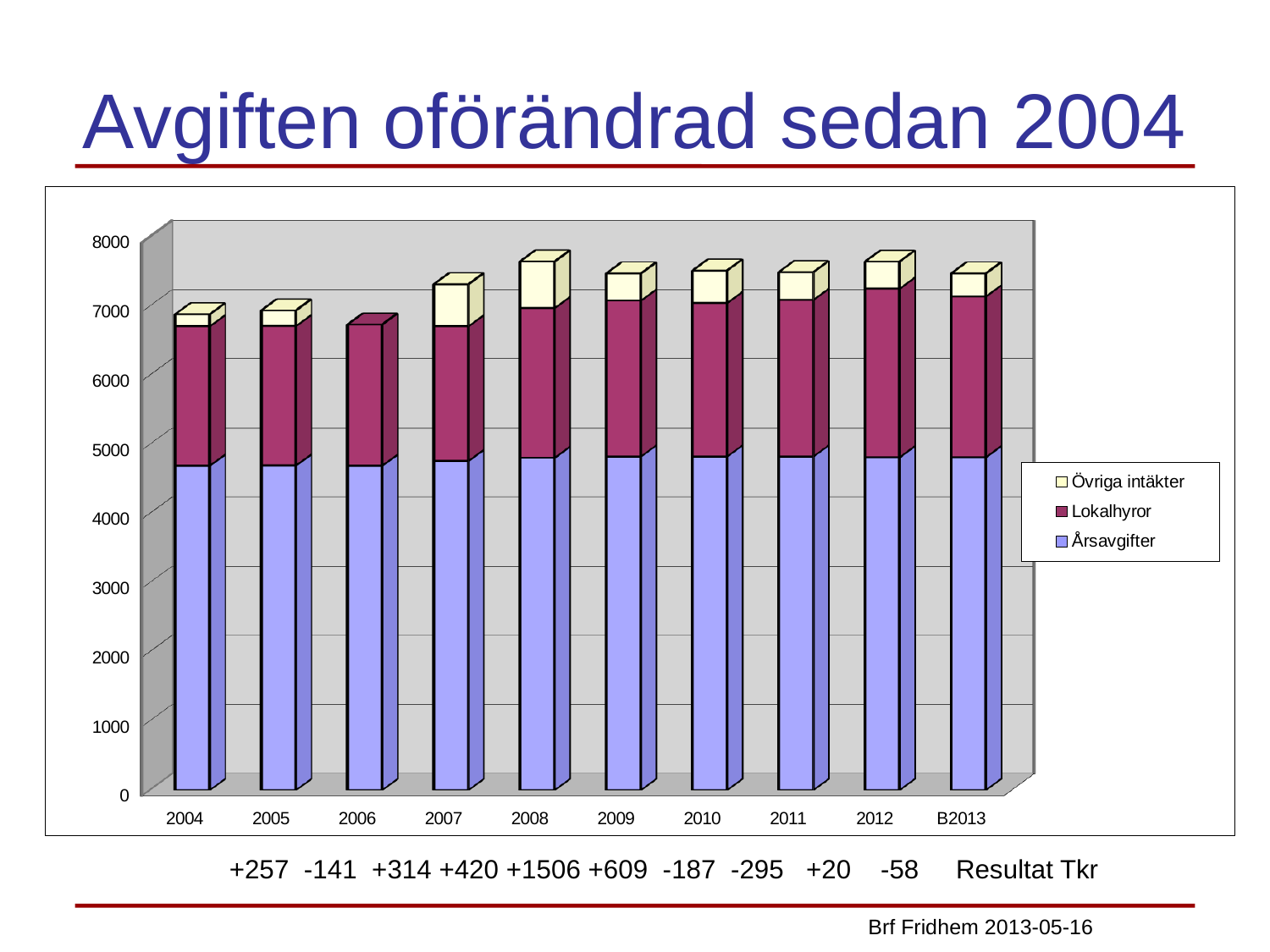
What kind of chart is shown on the slide? Stacked bar chart Is the Årsavgifter value for 2004 greater or less than 5000? less Is the total height of the 2006 bar greater or less than 7000? less Is the total height of the 2012 bar greater or less than 7000? greater Which year has the shortest stacked bar in the chart? 2006 How many years (categories) are shown on the x axis of the chart? 10 Which is taller, the stacked bar for 2008 or the stacked bar for 2005? 2008 How many series does the chart's legend list? 3 What is the title of the slide containing the chart? Avgiften oförändrad sedan 2004 Which series is shown at the bottom of each stacked bar according to the legend? Årsavgifter